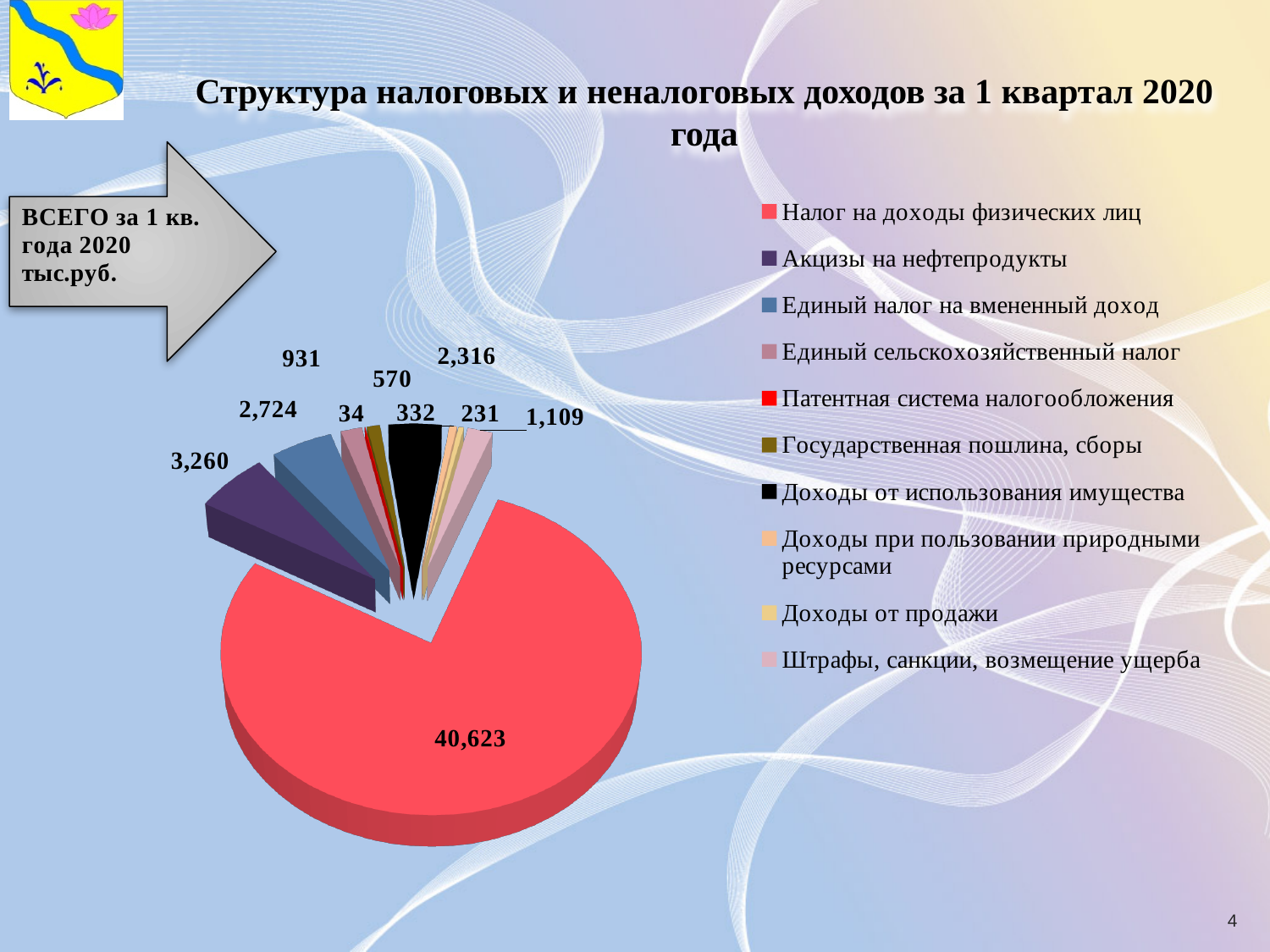
What is the value for Единый сельскохозяйственный налог? 931 Which category has the smallest value in the pie chart? Патентная система налогообложения How many entries does the legend list? 10 What is the difference between the values for Акцизы на нефтепродукты and Единый налог на вмененный доход? 536 What is the value for Акцизы на нефтепродукты? 3,260 What kind of chart is shown on the slide? pie chart What is the value for Единый налог на вмененный доход? 2,724 Which category has the largest slice of the pie? Налог на доходы физических лиц What is the value for Налог на доходы физических лиц? 40,623 What is the title of the slide's chart? Структура налоговых и неналоговых доходов за 1 квартал 2020 года What is the value for Патентная система налогообложения? 34 Which is larger: Акцизы на нефтепродукты or Единый сельскохозяйственный налог? Акцизы на нефтепродукты